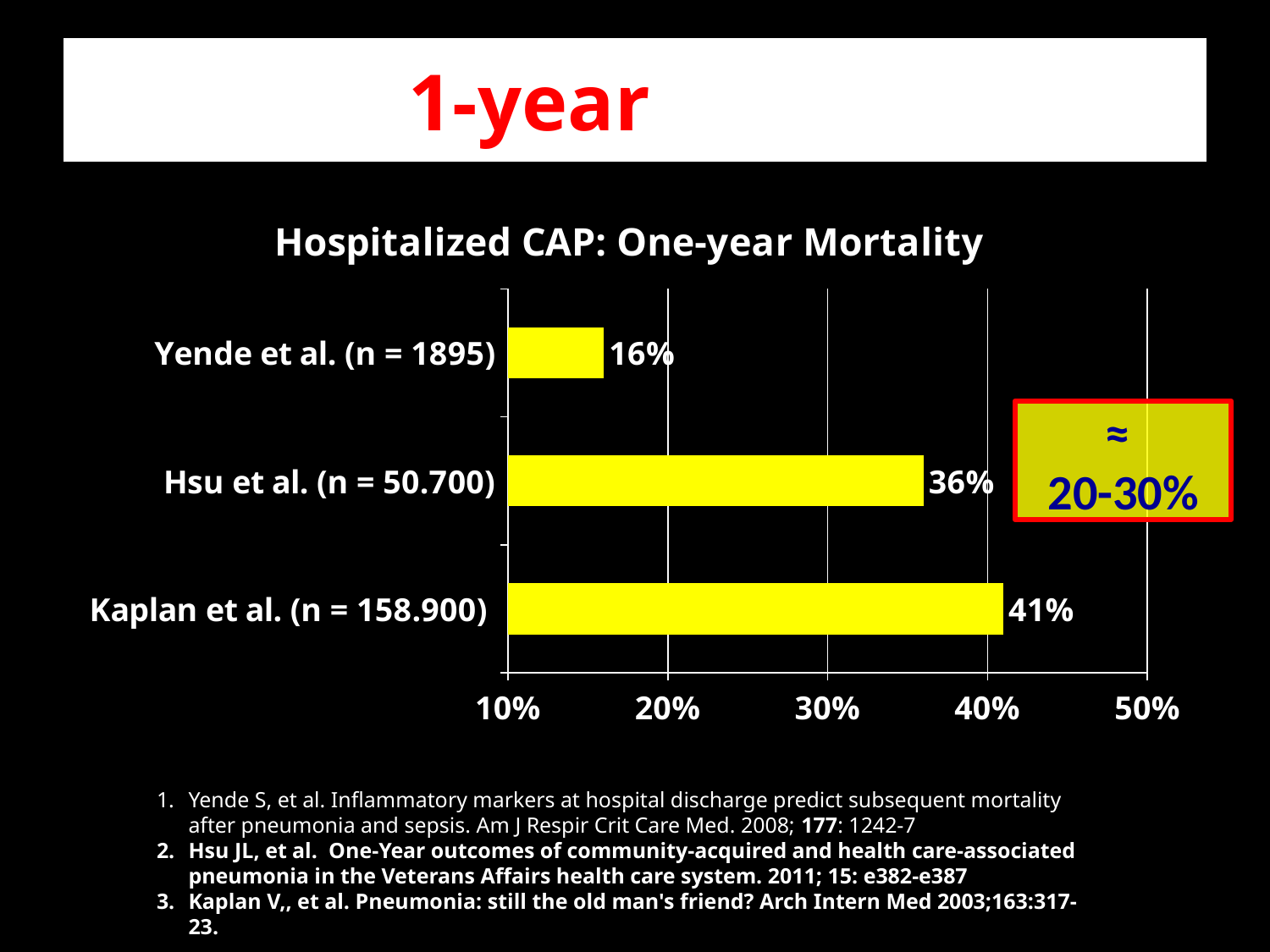
Is the value for Hsu et al. greater or less than 30%? greater Which has a higher one-year mortality, Hsu et al. or Yende et al.? Hsu et al. What is the one-year mortality value for Kaplan et al. (n = 158.900)? 41% What kind of chart is shown on the slide? Bar chart Which study has the highest one-year mortality? Kaplan et al. (n = 158.900) What is the difference between the mortality values for Kaplan et al. and Hsu et al.? 5% What is the one-year mortality value for Hsu et al. (n = 50.700)? 36% What is the one-year mortality value for Yende et al. (n = 1895)? 16% How many studies are shown in the chart? 3 Which study has the lowest one-year mortality? Yende et al. (n = 1895) What is the title of the chart? Hospitalized CAP: One-year Mortality What is the difference between the mortality values for Kaplan et al. and Yende et al.? 25%